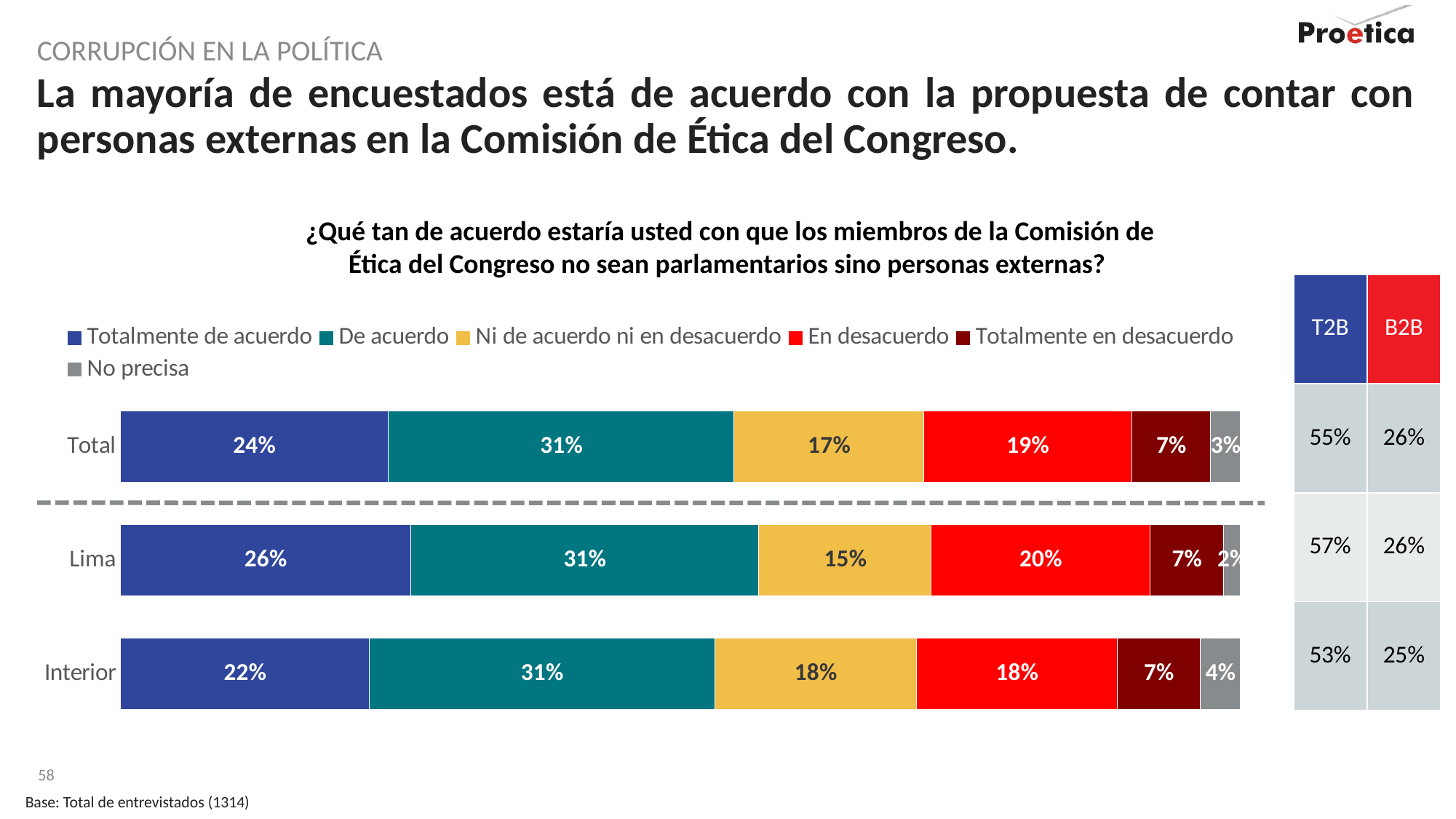
What is the difference between the "Totalmente de acuerdo" values for Lima and Interior? 4% Which category (Total, Lima or Interior) has the lowest "Totalmente de acuerdo" value? Interior What percentage of the Total group answered "Totalmente de acuerdo"? 24% What kind of chart is shown on the slide? Stacked bar chart Which is larger for the Total group: "De acuerdo" or "En desacuerdo"? De acuerdo What colour represents "De acuerdo" in the legend? Teal What is the "Ni de acuerdo ni en desacuerdo" value for Lima? 15% What percentage of respondents in Lima answered "En desacuerdo"? 20% What percentage of respondents in Interior answered "No precisa"? 4% How many categories (bars) are shown in the chart? 3 Which category (Total, Lima or Interior) has the highest "Totalmente de acuerdo" value? Lima How many series does the legend list? 6